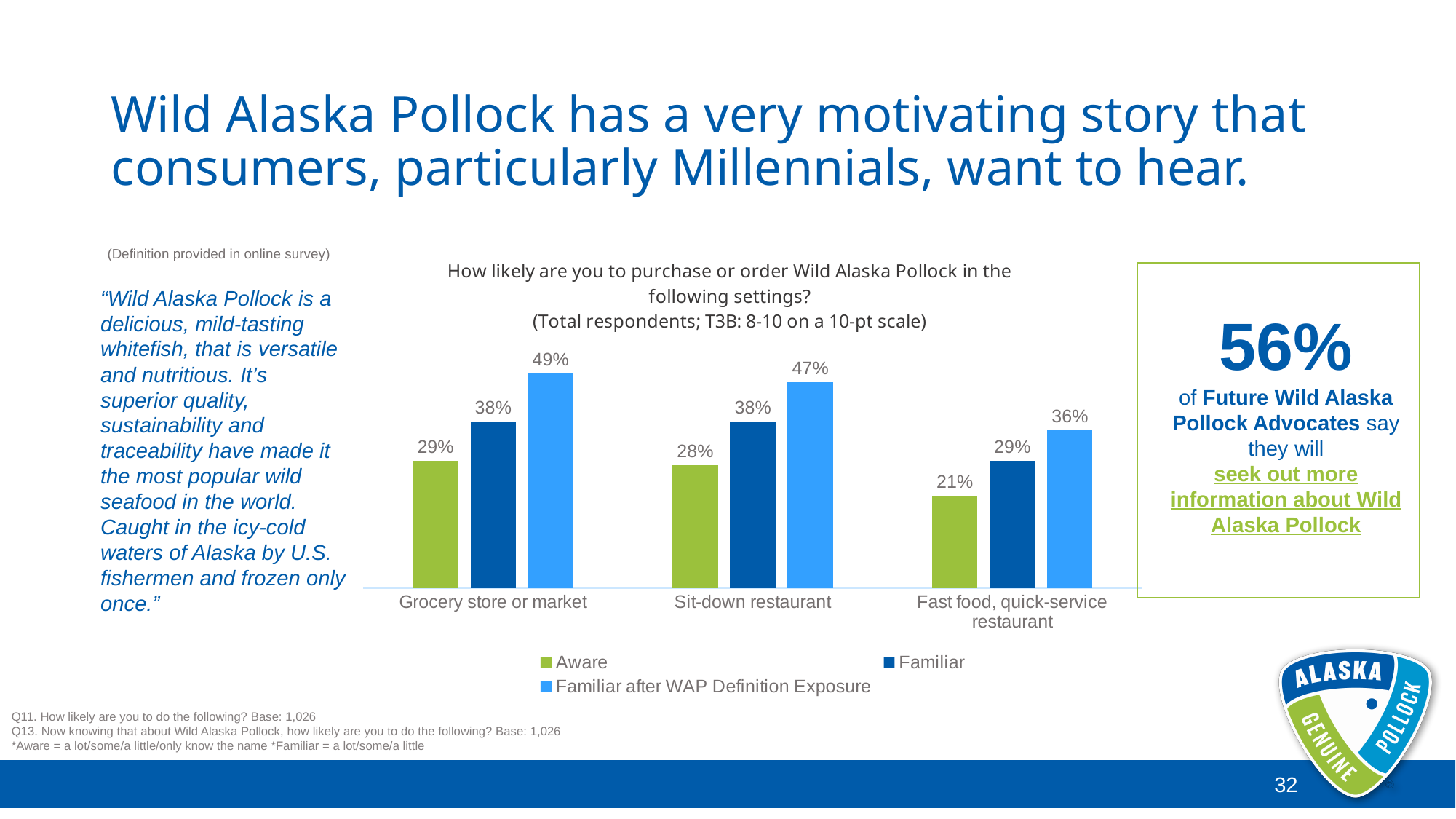
Which is larger at Sit-down restaurant: the Aware value or the Familiar value? Familiar Do the Aware values rise or fall from Grocery store or market to Fast food, quick-service restaurant? Fall What kind of chart is shown on the slide? Bar chart Which setting has the lowest value for Aware? Fast food, quick-service restaurant Which series is shown in light blue in the chart legend? Familiar after WAP Definition Exposure What is the value for Familiar at Fast food, quick-service restaurant? 29% What is the value for Aware at Grocery store or market? 29% How many series does the chart legend list? 3 How many settings (categories) are shown on the x axis of the chart? 3 What is the value for Familiar after WAP Definition Exposure at Sit-down restaurant? 47% Which setting has the highest value for Familiar after WAP Definition Exposure? Grocery store or market What is the difference between the Familiar after WAP Definition Exposure value and the Aware value at Grocery store or market? 20%